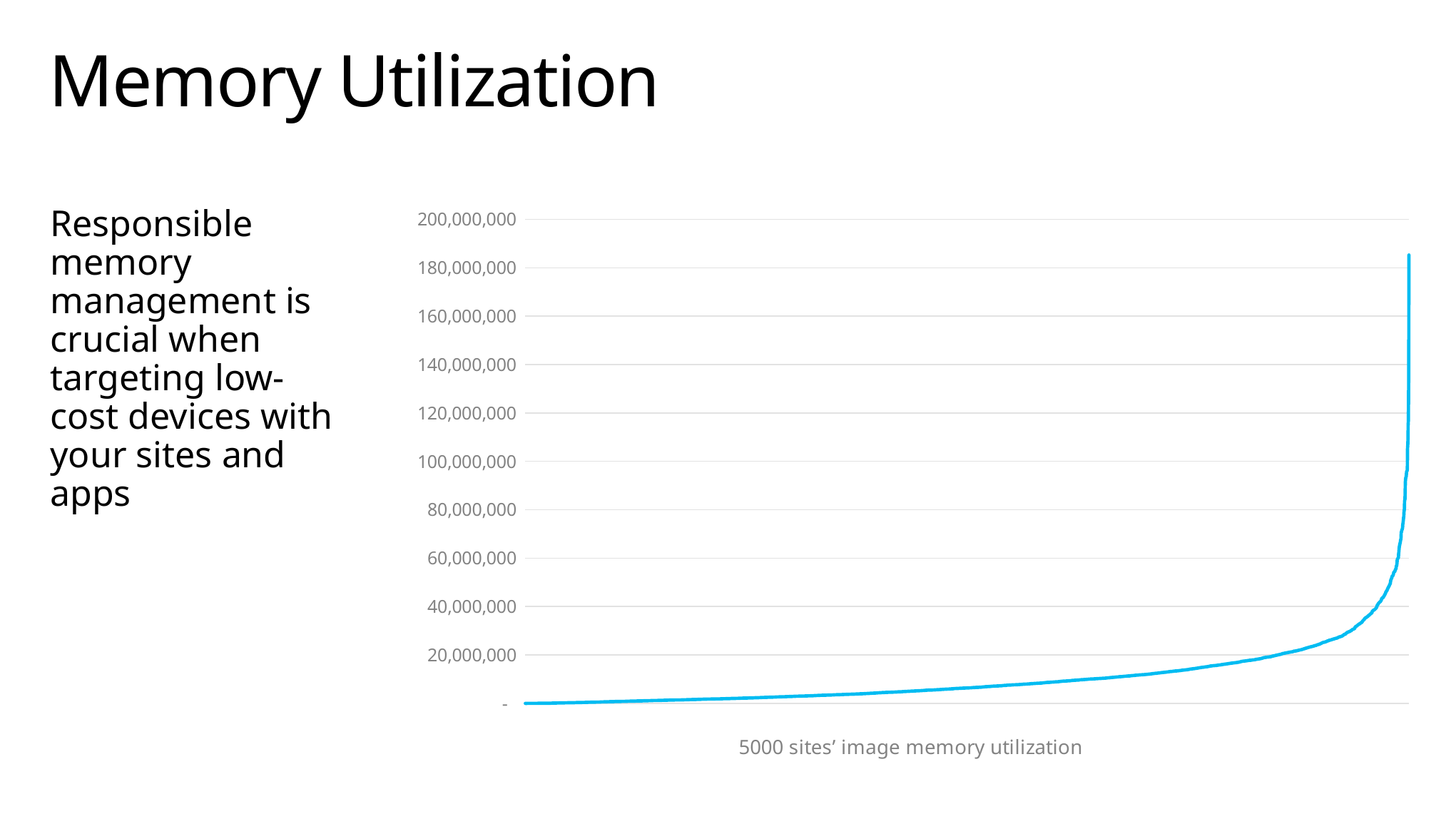
According to the caption below the chart, how many sites' image memory utilization is plotted? 5000 How many lines are plotted on the chart? 1 Are the values across most of the chart's width greater or less than 40,000,000? less What is the highest tick value shown on the vertical axis? 200,000,000 Is the highest value reached by the line greater or less than 200,000,000? less Is the value at the left end of the line greater or less than 20,000,000? less What is the caption printed below the chart? 5000 sites' image memory utilization What kind of chart is shown on the slide? line chart Do the values on the chart rise or fall from left to right along the x axis? rise